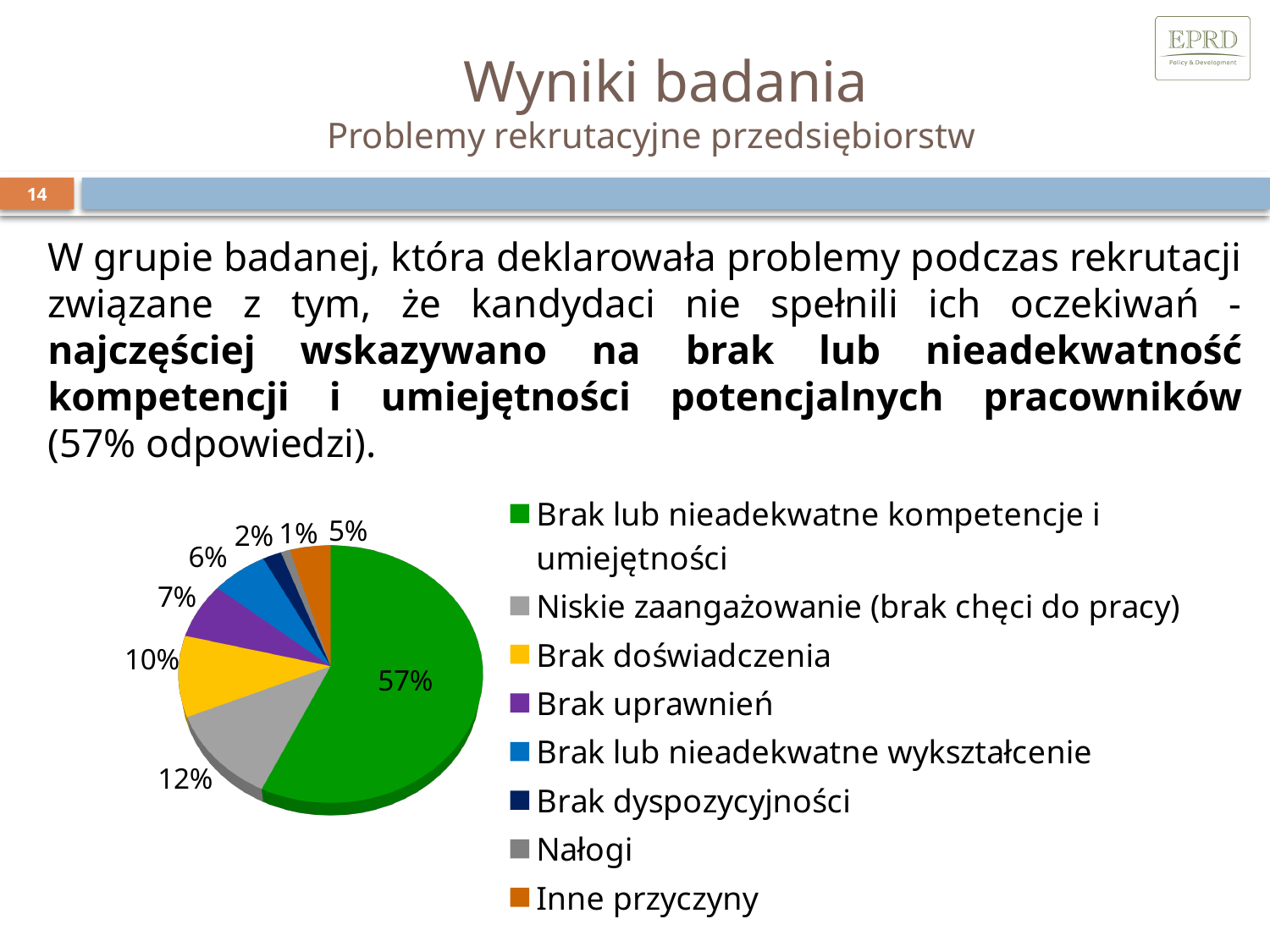
What is the value for "Niskie zaangażowanie (brak chęci do pracy)"? 12% Which category has the largest slice of the pie? Brak lub nieadekwatne kompetencje i umiejętności What is the value for "Inne przyczyny"? 5% What is the difference between the values for "Niskie zaangażowanie (brak chęci do pracy)" and "Brak doświadczenia"? 2% How many categories does the pie chart have? 8 Which is larger, the value for "Brak lub nieadekwatne wykształcenie" or the value for "Brak dyspozycyjności"? Brak lub nieadekwatne wykształcenie What is the value for "Brak uprawnień"? 7% What share of the pie does "Brak lub nieadekwatne kompetencje i umiejętności" have? 57% Which category has the smallest slice of the pie? Nałogi What kind of chart is shown on the slide? pie chart What is the value for "Brak doświadczenia"? 10% What colour is the slice for "Brak doświadczenia"? yellow